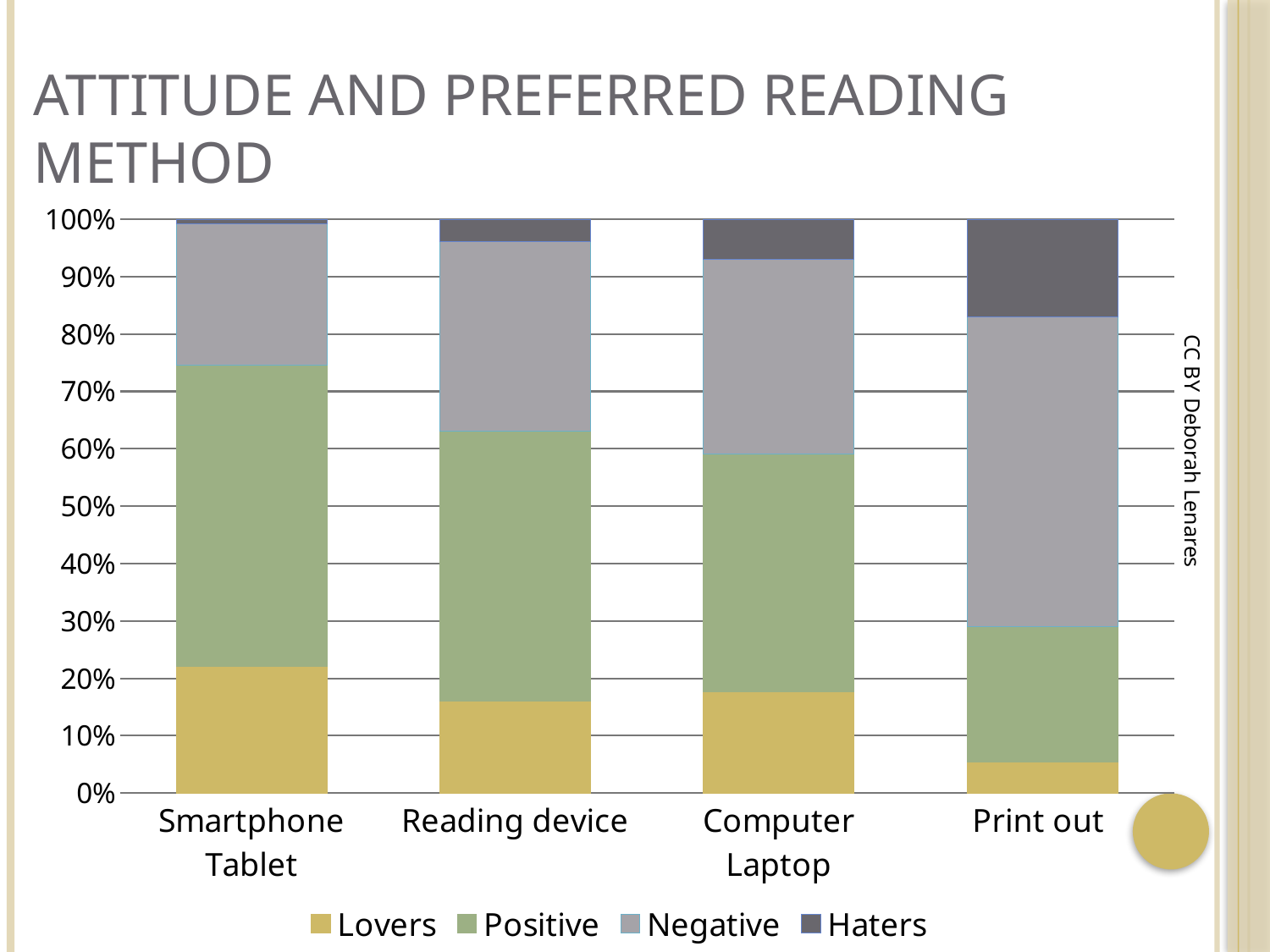
Which category has the largest Lovers segment? Smartphone Tablet Which is larger, the Haters segment for Print out or the Haters segment for Computer Laptop? Print out Which category has the largest Haters segment? Print out What kind of chart is shown on the slide? Stacked bar chart What is the title of the chart? Attitude and Preferred Reading Method Which category has the largest Positive segment? Smartphone Tablet Is the Haters value for Print out greater or less than 10%? greater Is the Lovers value for Print out greater or less than 10%? less Which category has the smallest Lovers segment? Print out How many reading methods (categories) are shown on the x axis? 4 How many series does the legend list? 4